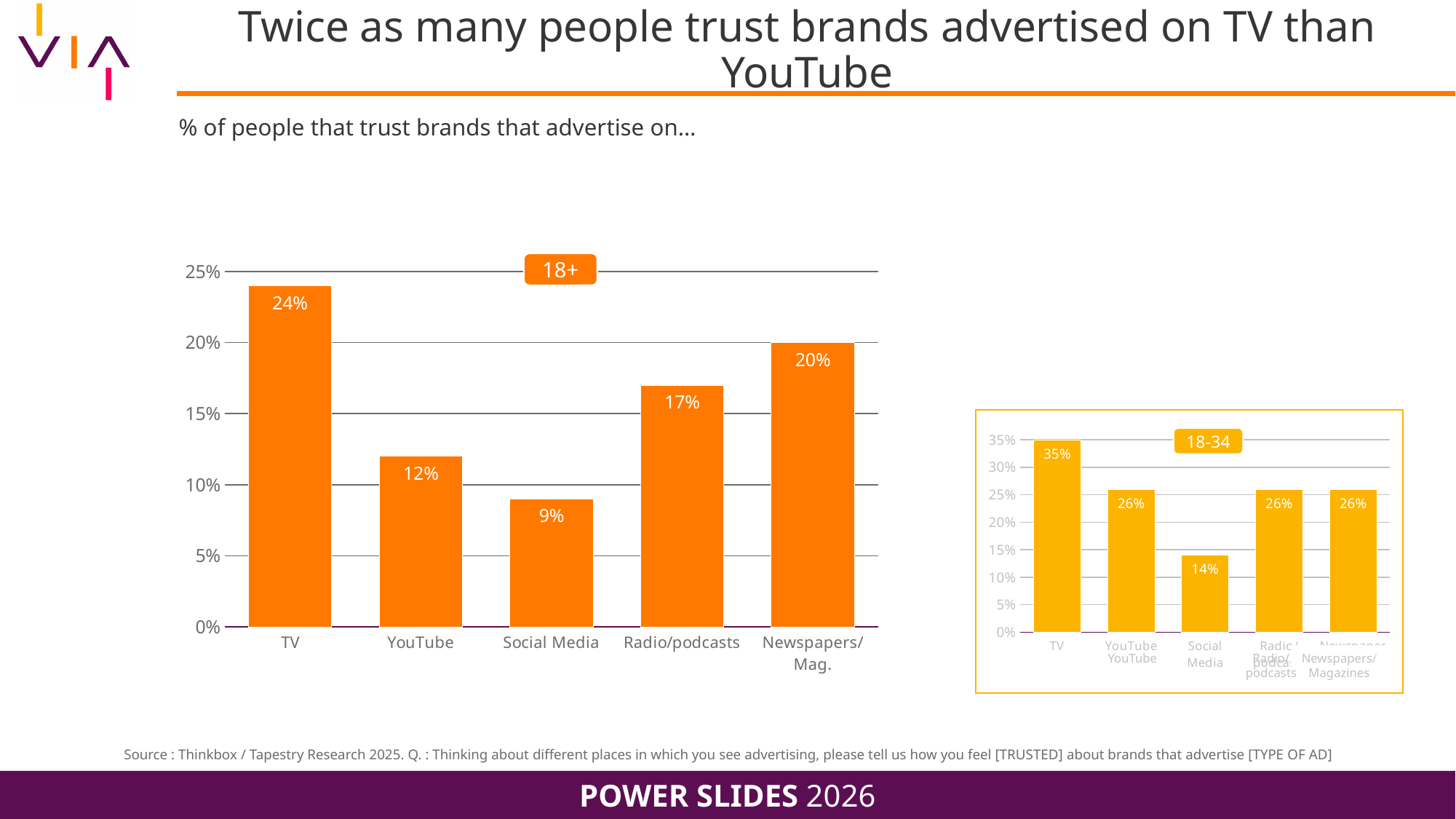
In the 18-34 chart, what is the value for TV? 35% In the 18+ chart, which category has the lowest value? Social Media What type of chart is the 18+ chart? Bar chart In the 18-34 chart, what is the difference between the TV value and the Social Media value? 21% What is the subtitle text above the charts describing what is plotted? % of people that trust brands that advertise on… In the 18+ chart, what is the value for Social Media? 9% In the 18+ chart, which category has the highest value? TV How many categories are shown in the 18+ chart? 5 In the 18+ chart, what percentage of people trust brands that advertise on TV? 24% In the 18+ chart, what is the difference between the TV value and the YouTube value? 12% In the 18-34 chart, what is the value for Social Media? 14% In the 18+ chart, which is larger: Radio/podcasts or Newspapers/Mag.? Newspapers/Mag.